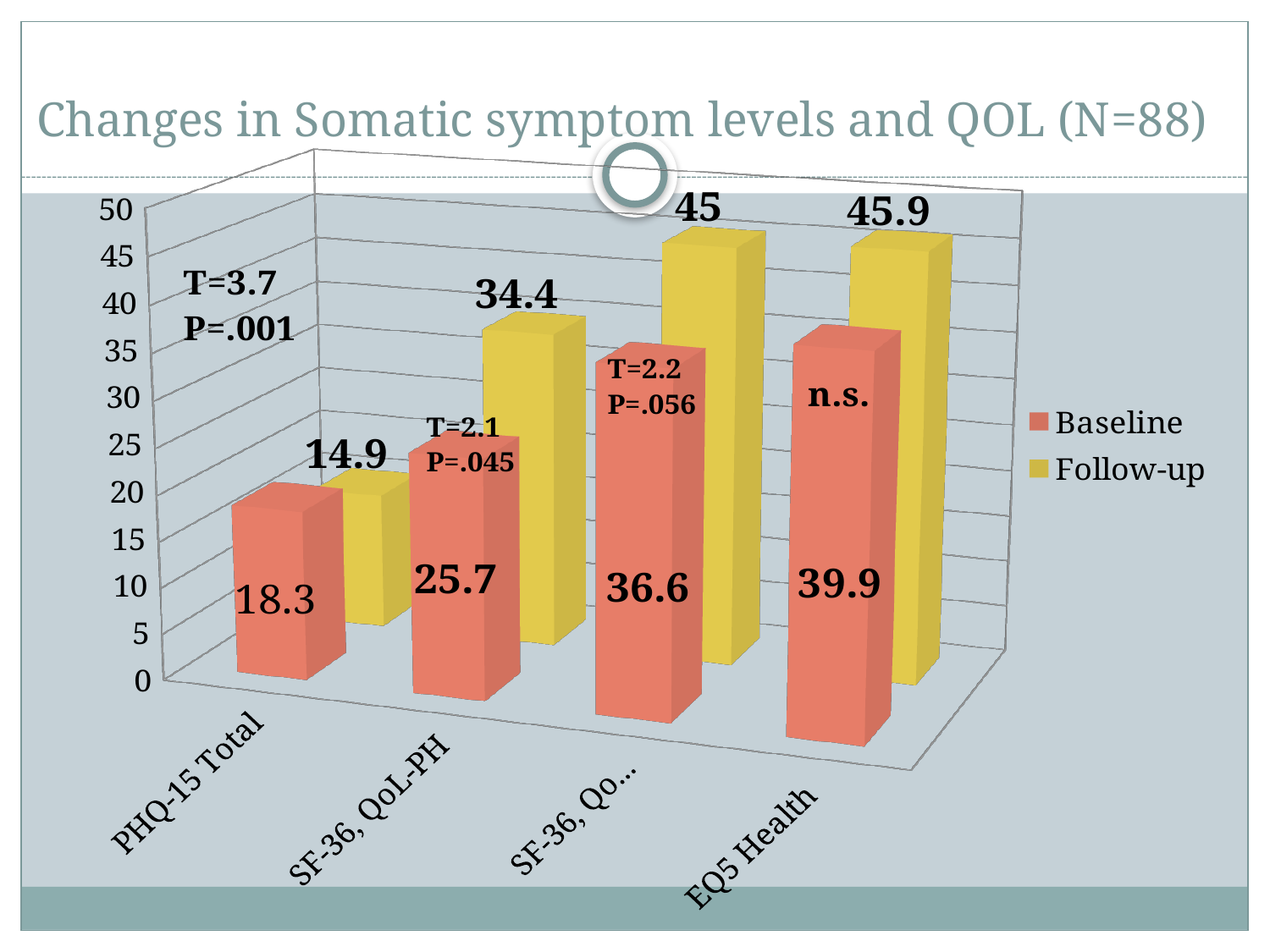
What is the Baseline value for PHQ-15 Total? 18.3 What is the difference between the Follow-up and Baseline values for SF-36, QoL-PH? 8.7 Which category has the highest Follow-up value? EQ5 Health How many series does the legend list? 2 What is the Follow-up value for SF-36, QoL-PH? 34.4 What is the Baseline value for SF-36, QoL-PH? 25.7 What is the Follow-up value for EQ5 Health? 45.9 What kind of chart is shown on the slide? Bar chart How many categories are shown on the x axis? 4 For PHQ-15 Total, which is larger, the Baseline or the Follow-up value? Baseline Which category has the lowest Baseline value? PHQ-15 Total What is the Follow-up value for PHQ-15 Total? 14.9